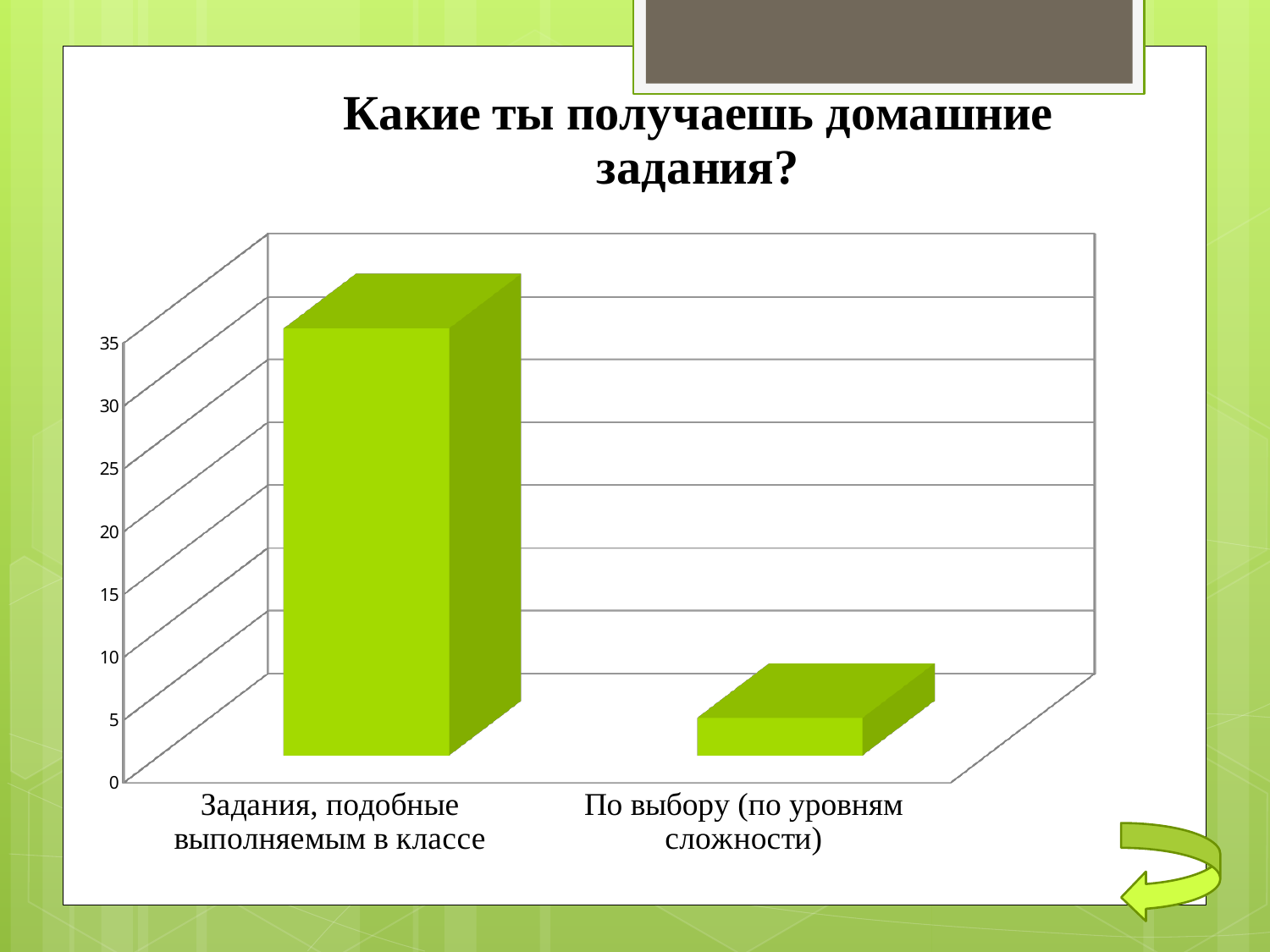
Which is larger: the value for "Задания, подобные выполняемым в классе" or the value for "По выбору (по уровням сложности)"? Задания, подобные выполняемым в классе Which category has the lowest value? По выбору (по уровням сложности) What is the title of the chart? Какие ты получаешь домашние задания? What is the highest value shown on the vertical axis? 35 How many categories are shown on the chart? 2 Is the value for "Задания, подобные выполняемым в классе" greater or less than 20? greater Which category has the highest value? Задания, подобные выполняемым в классе Is the value for "Задания, подобные выполняемым в классе" greater or less than 30? greater What kind of chart is shown on the slide? bar chart Is the value for "По выбору (по уровням сложности)" greater or less than 10? less Do the values rise or fall from left to right along the x axis? fall